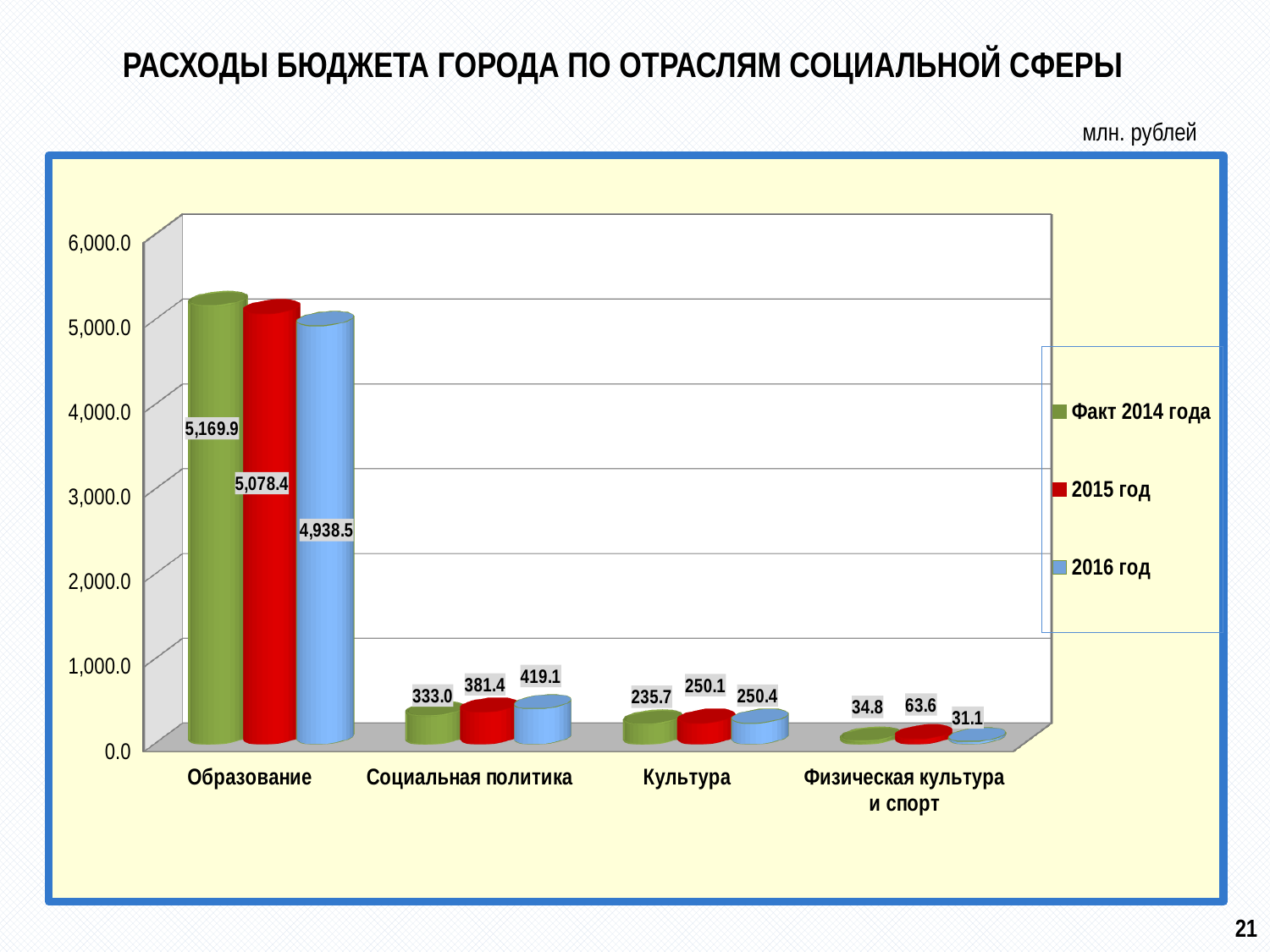
What is the value for Социальная политика in the 2016 год series? 419.1 What is the difference between the Факт 2014 года and 2016 год values for Образование? 231.4 What is the value for Физическая культура и спорт in the 2015 год series? 63.6 Which category has the lowest value in the 2016 год series? Физическая культура и спорт Which category has the highest value in the 2015 год series? Образование Is the 2016 год value for Образование greater or less than 4,000.0? greater Do the values for Образование rise or fall from Факт 2014 года to 2016 год? fall For Физическая культура и спорт, which is larger: the Факт 2014 года value or the 2015 год value? 2015 год What is the value for Образование in the Факт 2014 года series? 5,169.9 How many series does the legend list? 3 What is the difference between the 2016 год and Факт 2014 года values for Социальная политика? 86.1 How many categories are shown on the x axis? 4